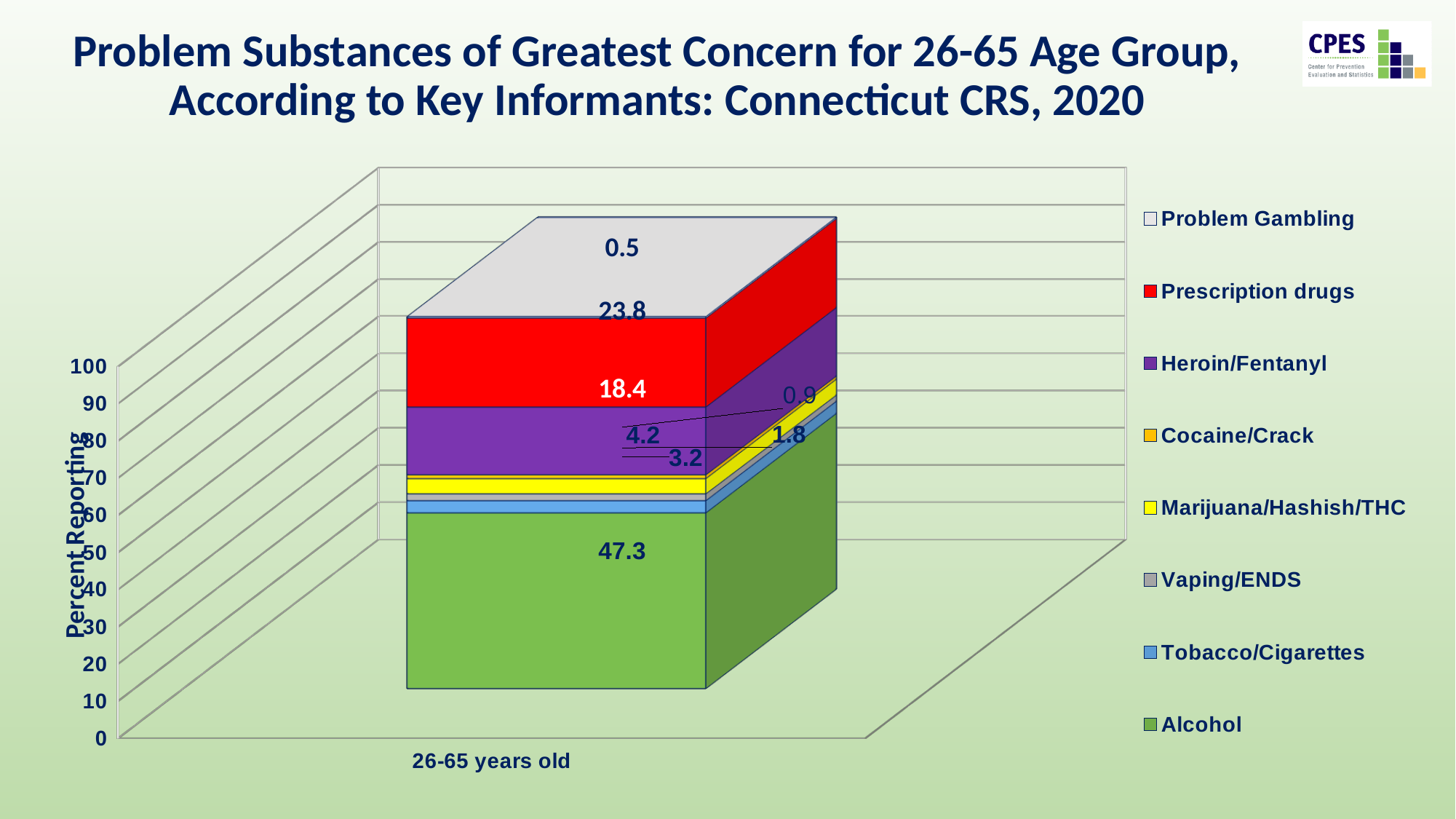
What value is shown for Problem Gambling in the 26-65 years old bar? 0.5 What value is shown for Alcohol in the 26-65 years old bar? 47.3 What value is shown for Prescription drugs in the 26-65 years old bar? 23.8 What value is shown for Heroin/Fentanyl in the 26-65 years old bar? 18.4 Which substance has the lowest value in the stacked bar? Problem Gambling What kind of chart is shown on the slide? Stacked bar chart Which is larger, the value for Heroin/Fentanyl or the value for Prescription drugs? Prescription drugs What is the difference between the Alcohol value and the Prescription drugs value? 23.5 What is the title of the vertical axis? Percent Reporting Which substance has the highest value in the stacked bar? Alcohol How many series does the legend list? 8 What is the difference between the Prescription drugs value and the Heroin/Fentanyl value? 5.4